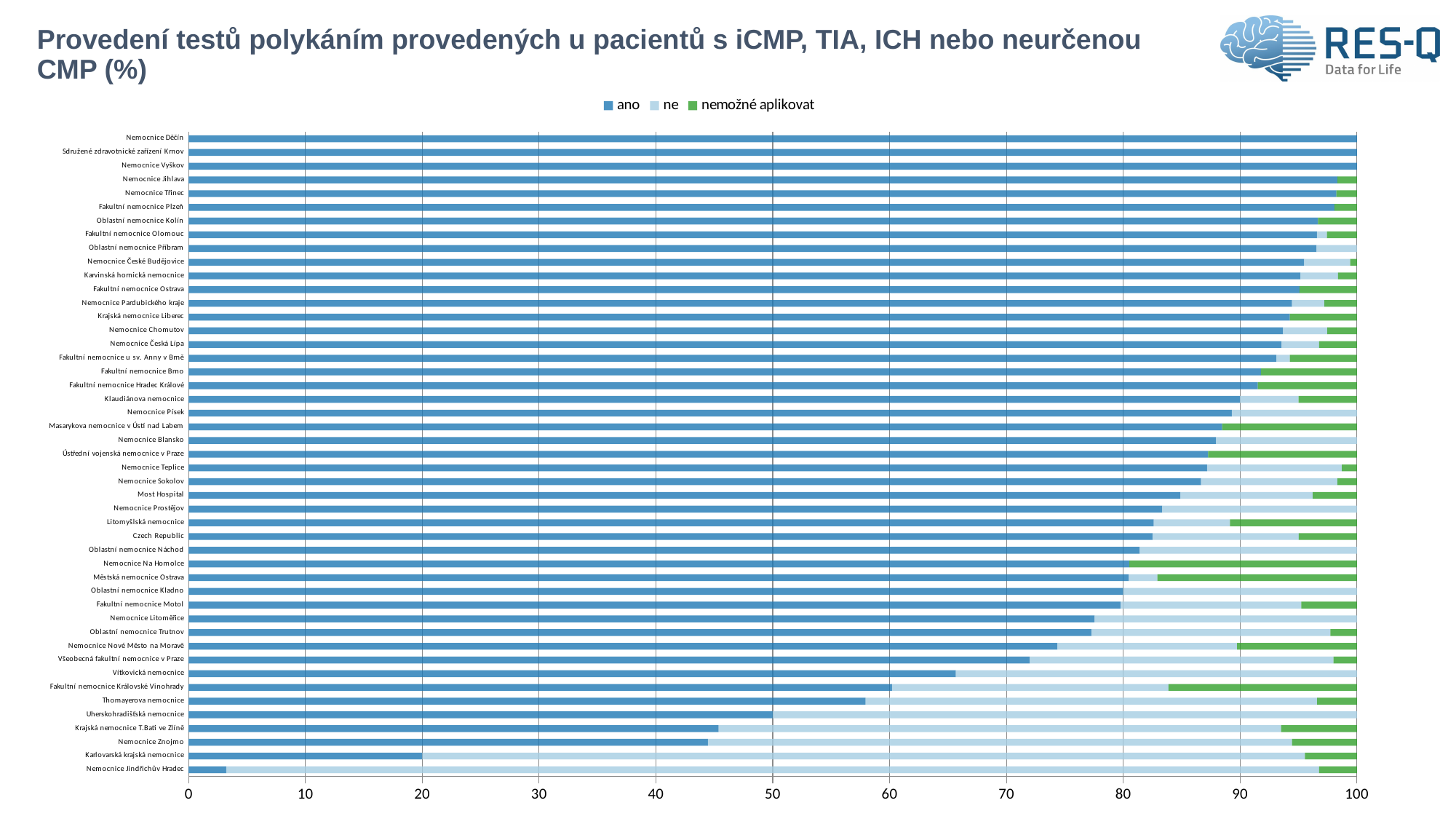
Which has the larger 'ano' value, Nemocnice Znojmo or Karlovarská krajská nemocnice? Nemocnice Znojmo Do the 'ano' values rise or fall going from the top of the chart to the bottom? fall Which hospital has the lowest 'ano' value? Nemocnice Jindřichův Hradec What are the three series named in the legend? ano, ne, nemožné aplikovat Is the 'ano' value for Vítkovická nemocnice greater or less than 60? greater What is the 'ano' value for Uherskohradišťská nemocnice? 50 Is the 'ano' value for Nemocnice Jindřichův Hradec greater or less than 10? less What kind of chart is shown on the slide? bar chart Is the 'ano' value for Nemocnice Znojmo greater or less than 50? less How many series does the legend list? 3 What is the 'ano' value for Nemocnice Děčín? 100 What is the 'ano' value for Karlovarská krajská nemocnice? 20